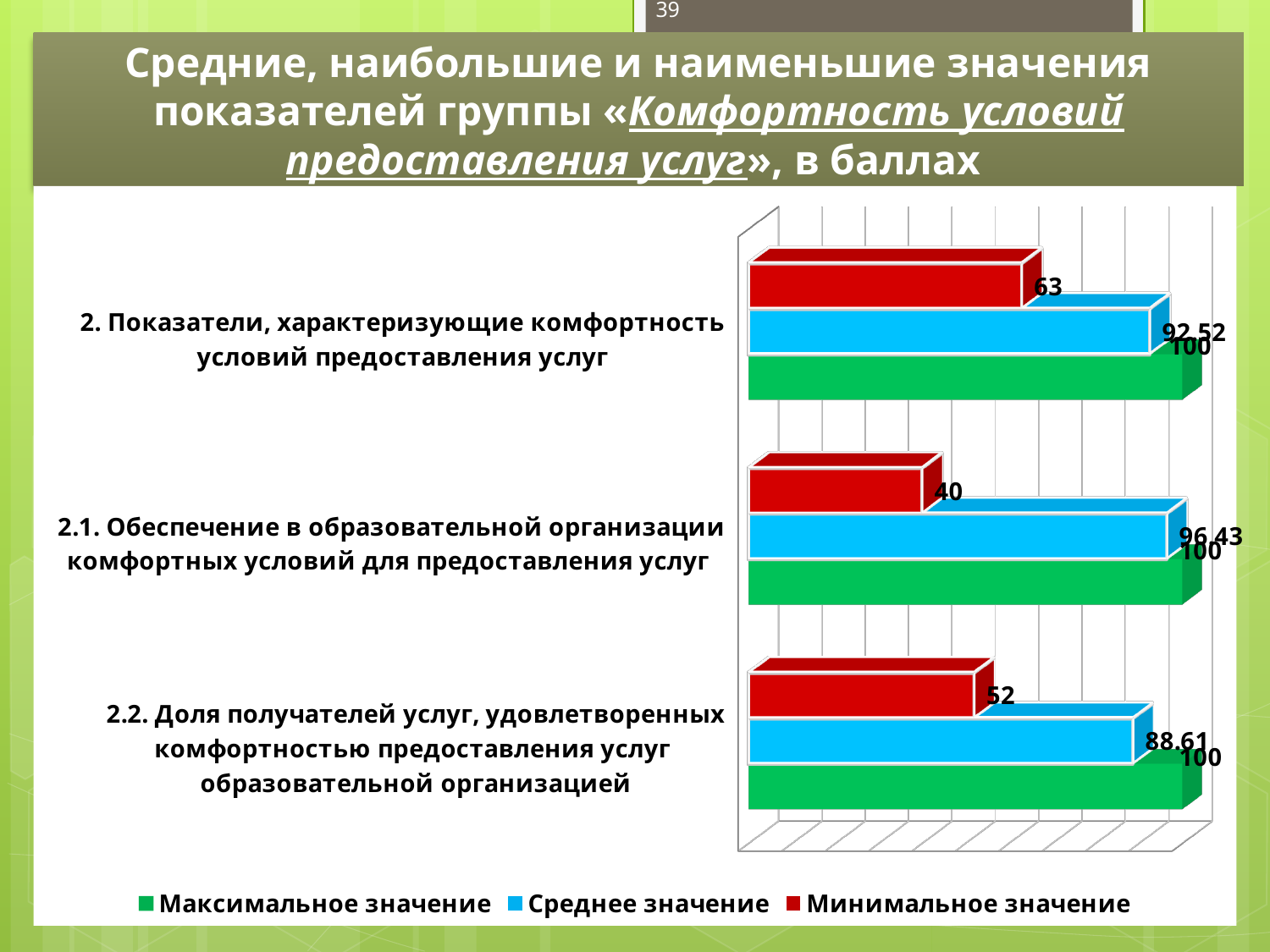
Which category has the lowest minimum value (Минимальное значение)? 2.1. Обеспечение в образовательной организации комфортных условий для предоставления услуг What kind of chart is shown on the slide? Bar chart What is the difference between the minimum values of category 2 and category 2.2? 11 Which colour represents Минимальное значение in the legend? Red Which is larger: the average value for category 2 or the average value for category 2.2? Category 2 (92.52) What is the minimum value (Минимальное значение) for category 2.1 «Обеспечение в образовательной организации комфортных условий для предоставления услуг»? 40 What is the average value (Среднее значение) for category 2.2 «Доля получателей услуг, удовлетворенных комфортностью предоставления услуг образовательной организацией»? 88.61 How many series does the legend list? 3 What is the maximum value (Максимальное значение) for category 2.1? 100 How many categories are shown on the chart? 3 What is the average value (Среднее значение) for category 2 «Показатели, характеризующие комфортность условий предоставления услуг»? 92.52 Which category has the highest average value (Среднее значение)? 2.1. Обеспечение в образовательной организации комфортных условий для предоставления услуг